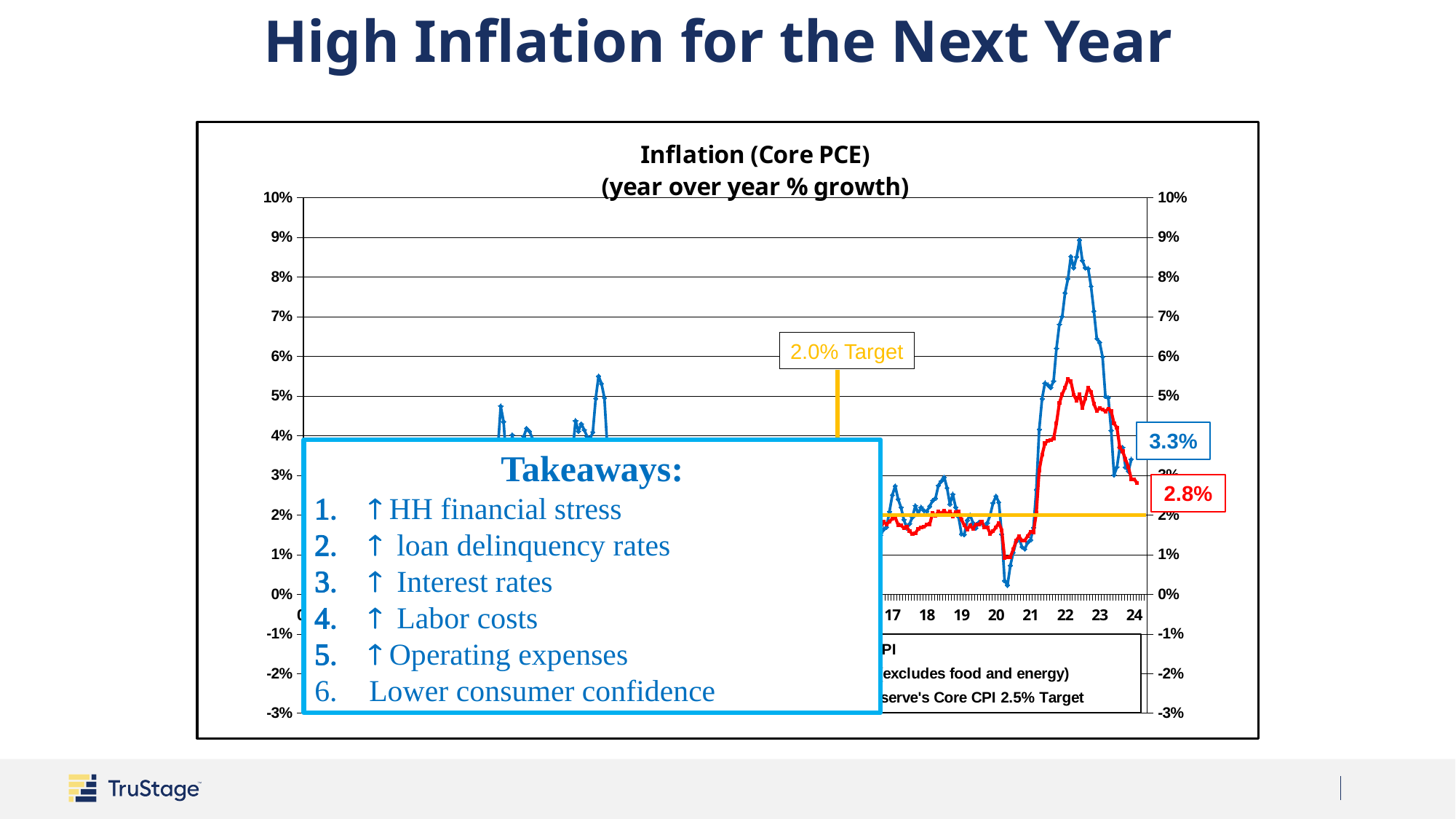
Is the lowest point of the blue line around 2020 greater or less than 1%? less Is the peak of the red line around 2022 greater or less than 5%? greater How many lines are plotted on the chart? 3 From the 2022 peak to 2024, do the values of the blue line rise or fall? Fall At the end of the series, which line has the higher labelled value, the blue line or the red line? The blue line What is the title of the chart? Inflation (Core PCE) (year over year % growth) Is the peak of the blue line around 2022 greater or less than 8%? greater What kind of chart is shown on the slide? Line chart What is the difference between the labelled end values of the blue line (3.3%) and the red line (2.8%)? 0.5% What target value is marked by the yellow horizontal line? 2.0% Target What is the latest value labelled on the blue line? 3.3% What is the latest value labelled on the red line? 2.8%